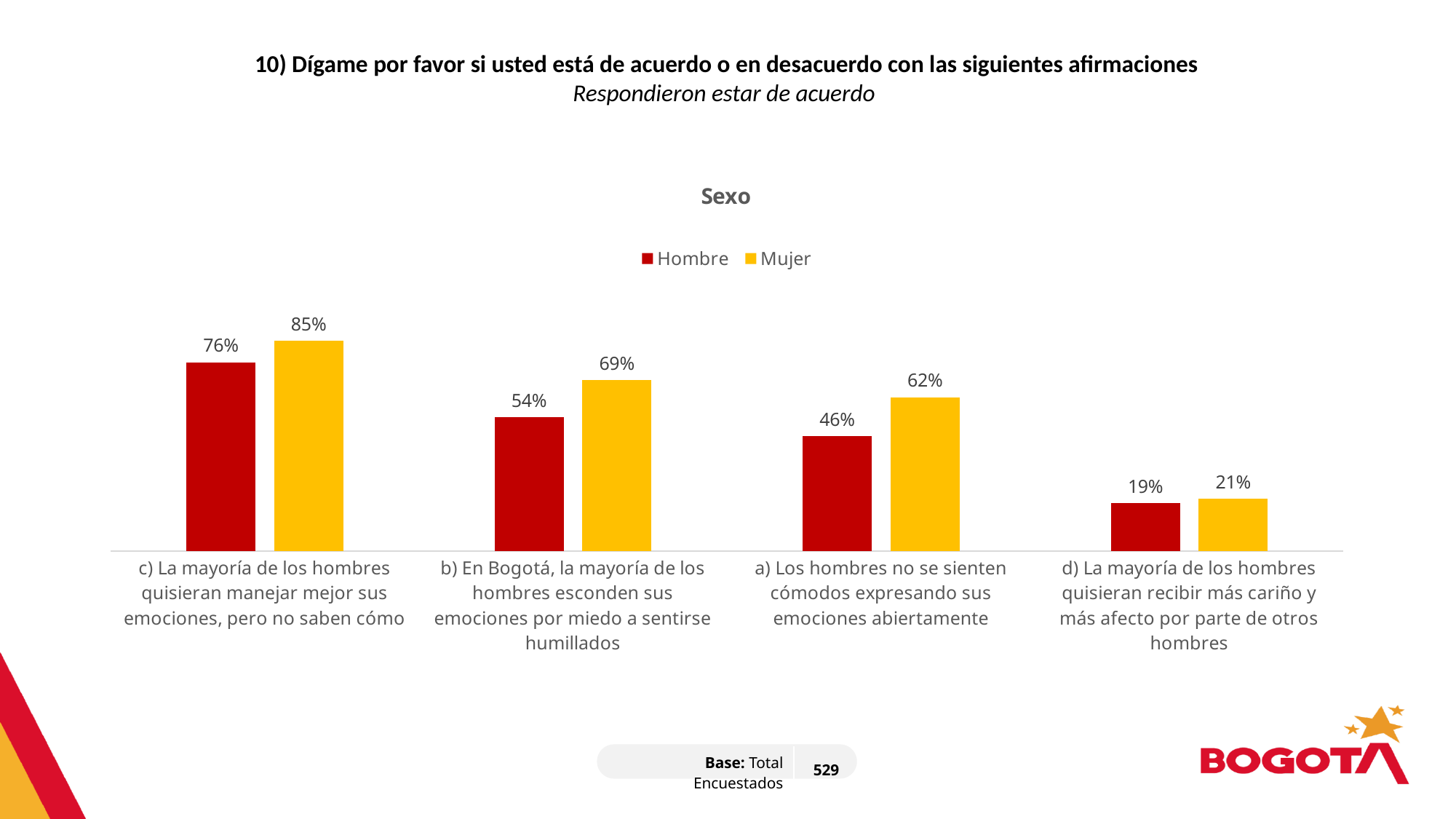
What is the Hombre value for statement a) Los hombres no se sienten cómodos expresando sus emociones abiertamente? 46% What kind of chart is shown on the slide? Bar chart Which statement has the highest Mujer value? c) La mayoría de los hombres quisieran manejar mejor sus emociones, pero no saben cómo What is the Mujer value for statement b) En Bogotá, la mayoría de los hombres esconden sus emociones por miedo a sentirse humillados? 69% What is the title of the chart? Sexo What is the Mujer value for statement d) La mayoría de los hombres quisieran recibir más cariño y más afecto por parte de otros hombres? 21% How many statements (categories) are shown on the chart? 4 How many series does the legend list? 2 For statement b) En Bogotá, la mayoría de los hombres esconden sus emociones por miedo a sentirse humillados, which is larger, the Hombre or the Mujer value? Mujer Which statement has the lowest Hombre value? d) La mayoría de los hombres quisieran recibir más cariño y más afecto por parte de otros hombres What is the difference between the Mujer and Hombre values for statement a) Los hombres no se sienten cómodos expresando sus emociones abiertamente? 16% What is the Hombre value for statement c) La mayoría de los hombres quisieran manejar mejor sus emociones, pero no saben cómo? 76%